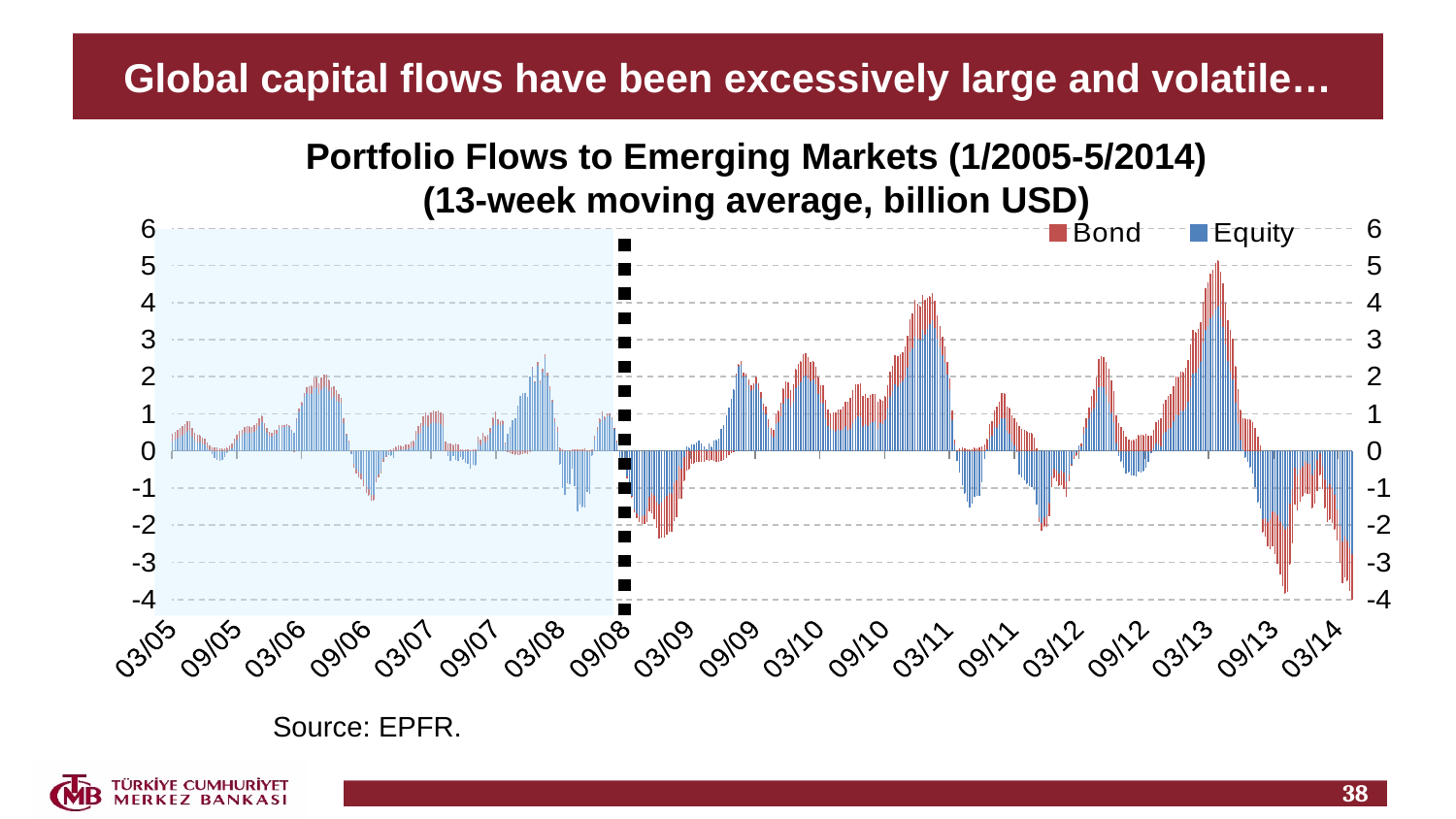
Which colour represents the Equity series? Blue What is the source cited for the chart? EPFR Is the trough of total portfolio flows around 03/09 greater or less than -1? less What is the highest value shown on the vertical axis? 6 What are the two series named in the legend? Bond and Equity Is the trough of total portfolio flows around 09/13 greater or less than -3? less How many date labels are shown along the x axis? 19 Is the peak of total portfolio flows shortly after 03/13 greater or less than 4? greater How many series does the legend list? 2 What kind of chart is shown on the slide? Bar chart What is the lowest value shown on the vertical axis? -4